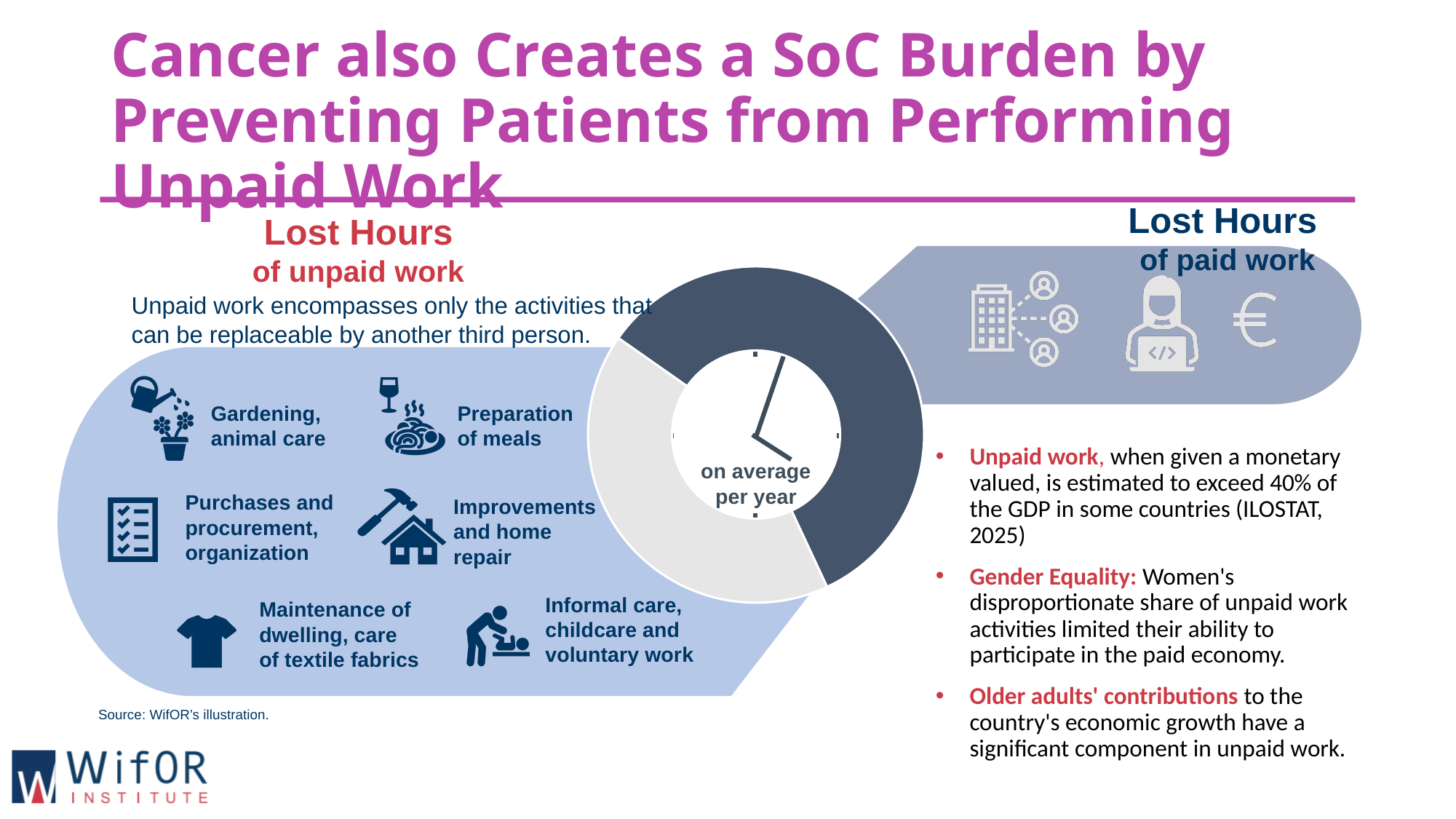
What kind of chart is shown in the centre of the slide, around the clock icon? Donut (pie) chart How many segments does the donut chart in the centre of the slide have? 2 What text is printed inside the centre of the donut chart? on average per year In the donut chart, which segment is larger: the dark blue-grey segment or the light grey segment? The dark blue-grey segment Does the donut chart in the centre of the slide show any numeric data labels? No